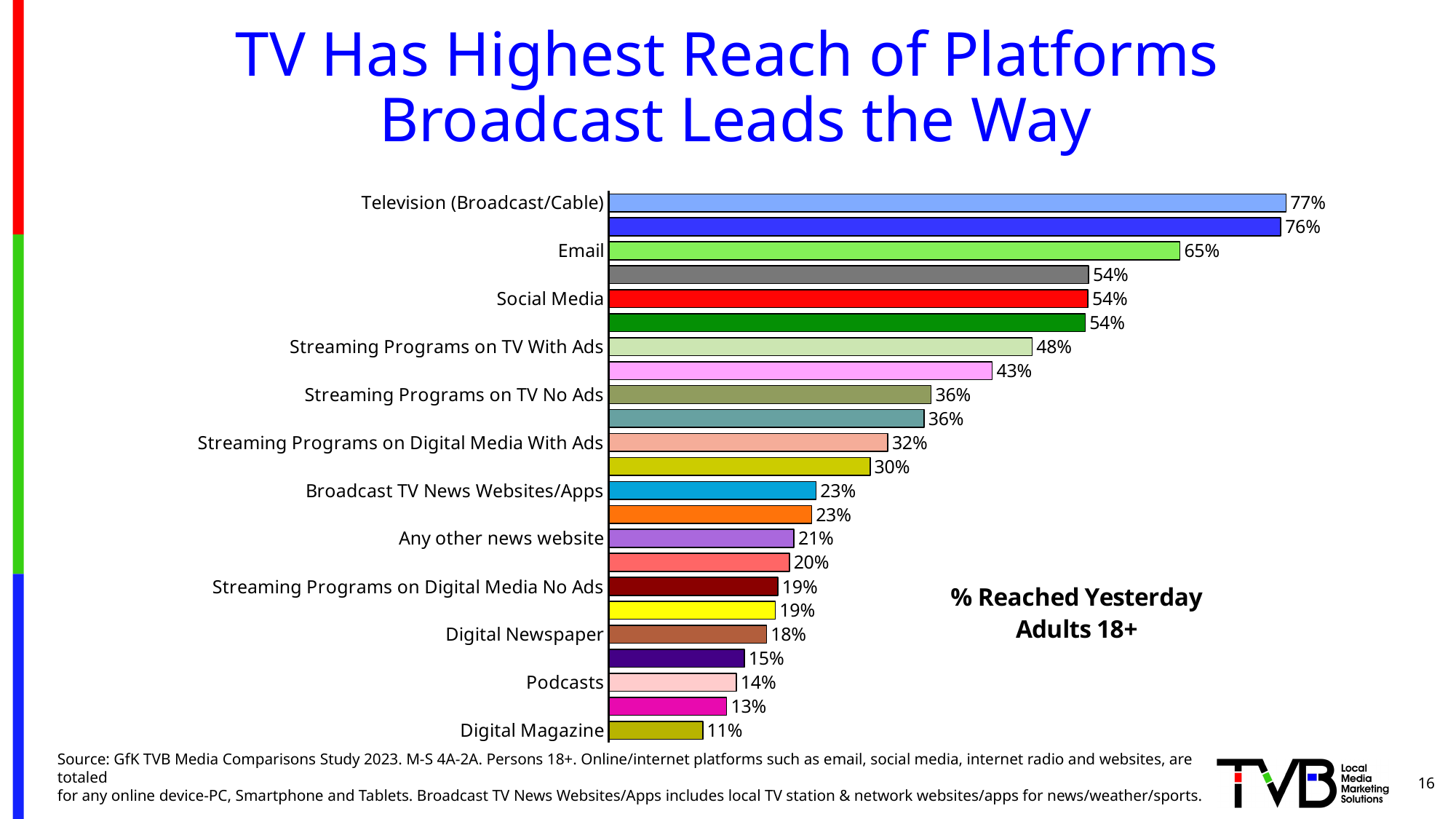
What measure does the text label inside the chart say the bars represent? % Reached Yesterday Adults 18+ What is the value for Television (Broadcast/Cable)? 77% Which is larger, the value for Email or the value for Social Media? Email Which category has the highest value? Television (Broadcast/Cable) What is the value for Podcasts? 14% What is the value for Streaming Programs on TV With Ads? 48% What is the value for Email? 65% How many bars are plotted in the chart? 23 What kind of chart is shown on the slide? bar chart What is the difference between the values for Television (Broadcast/Cable) and Email? 12 percentage points Which category has the lowest value? Digital Magazine Do the bar values increase or decrease going from the top of the chart to the bottom? decrease